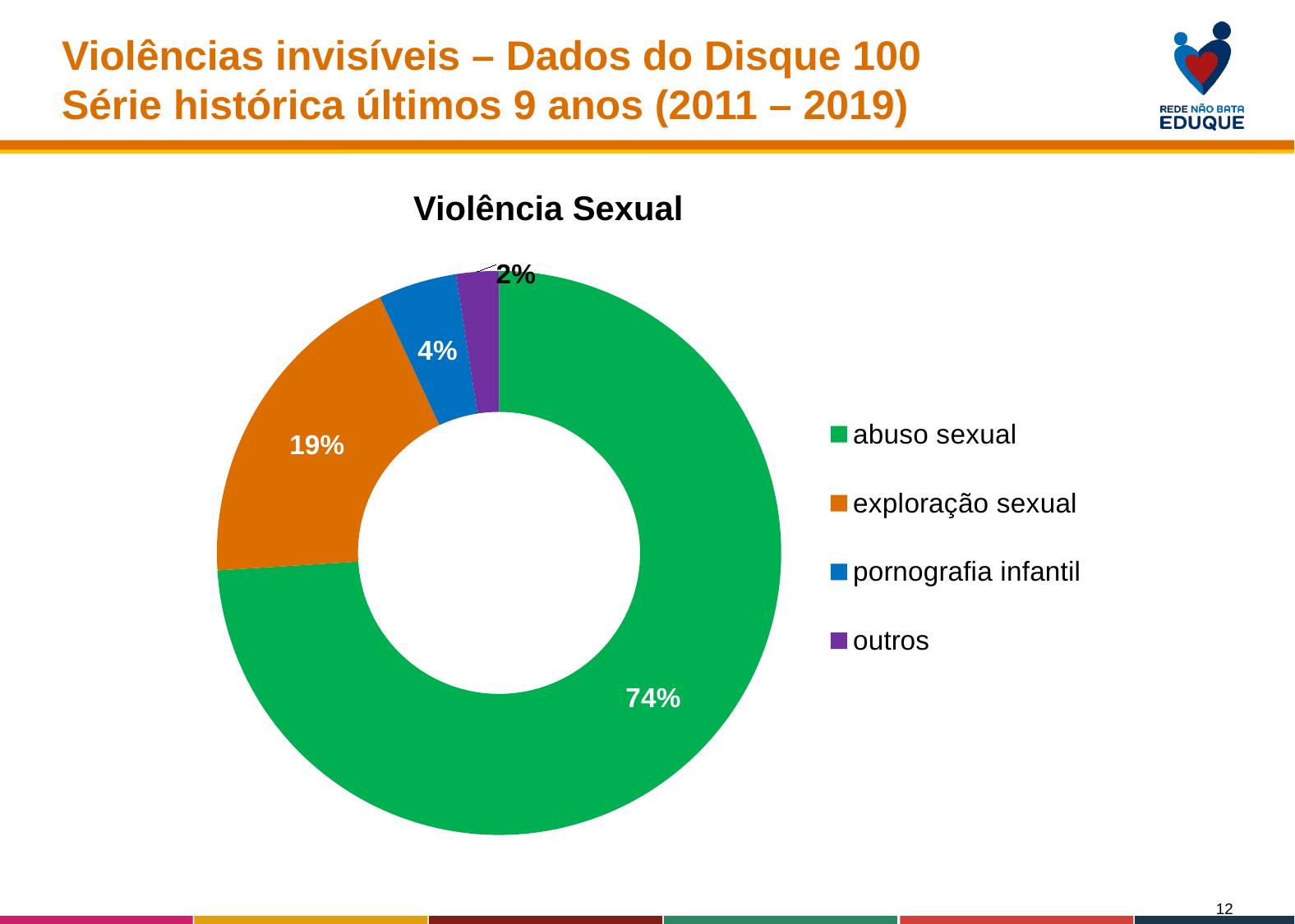
How many categories are shown in the chart? 4 What is the title of the chart? Violência Sexual What kind of chart is shown on the slide? pie chart (doughnut) What share of the pie does abuso sexual represent? 74% Which category has the largest share of the chart? abuso sexual What colour represents pornografia infantil in the chart? blue What is the value shown for pornografia infantil? 4% What is the difference in percentage points between abuso sexual and exploração sexual? 55 What is the value shown for exploração sexual? 19% Which is larger, the share for exploração sexual or the share for pornografia infantil? exploração sexual What is the value shown for outros? 2% Which category has the smallest share of the chart? outros